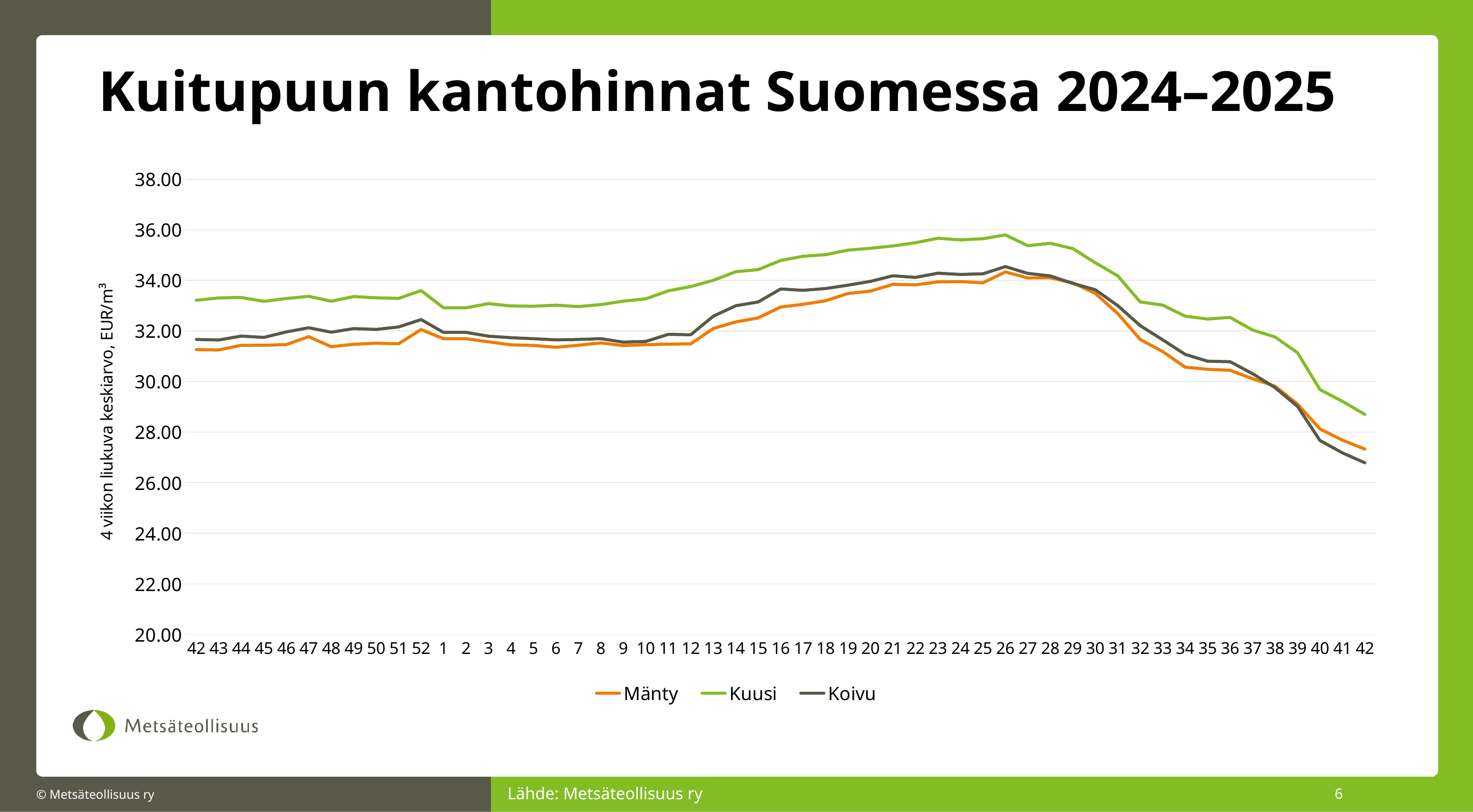
Do the values for Mänty rise or fall from week 12 to week 26? rise Is the value for Koivu at the final week 42 on the right of the chart greater or less than 28.00? less What is the title of the chart? Kuitupuun kantohinnat Suomessa 2024–2025 How many series does the legend list? 3 Do the values for Kuusi rise or fall from week 26 to the final week 42? fall Which series are listed in the legend? Mänty, Kuusi, Koivu Which series has the lowest value at the final week 42 on the right of the chart? Koivu Is the value for Mänty at the first week 42 on the left of the chart greater or less than 32.00? less Is the value for Kuusi at week 26 greater or less than 34.00? greater What kind of chart is shown on the slide? line chart Which series has the highest value at week 26? Kuusi At week 26, which is larger: the value for Kuusi or the value for Mänty? Kuusi